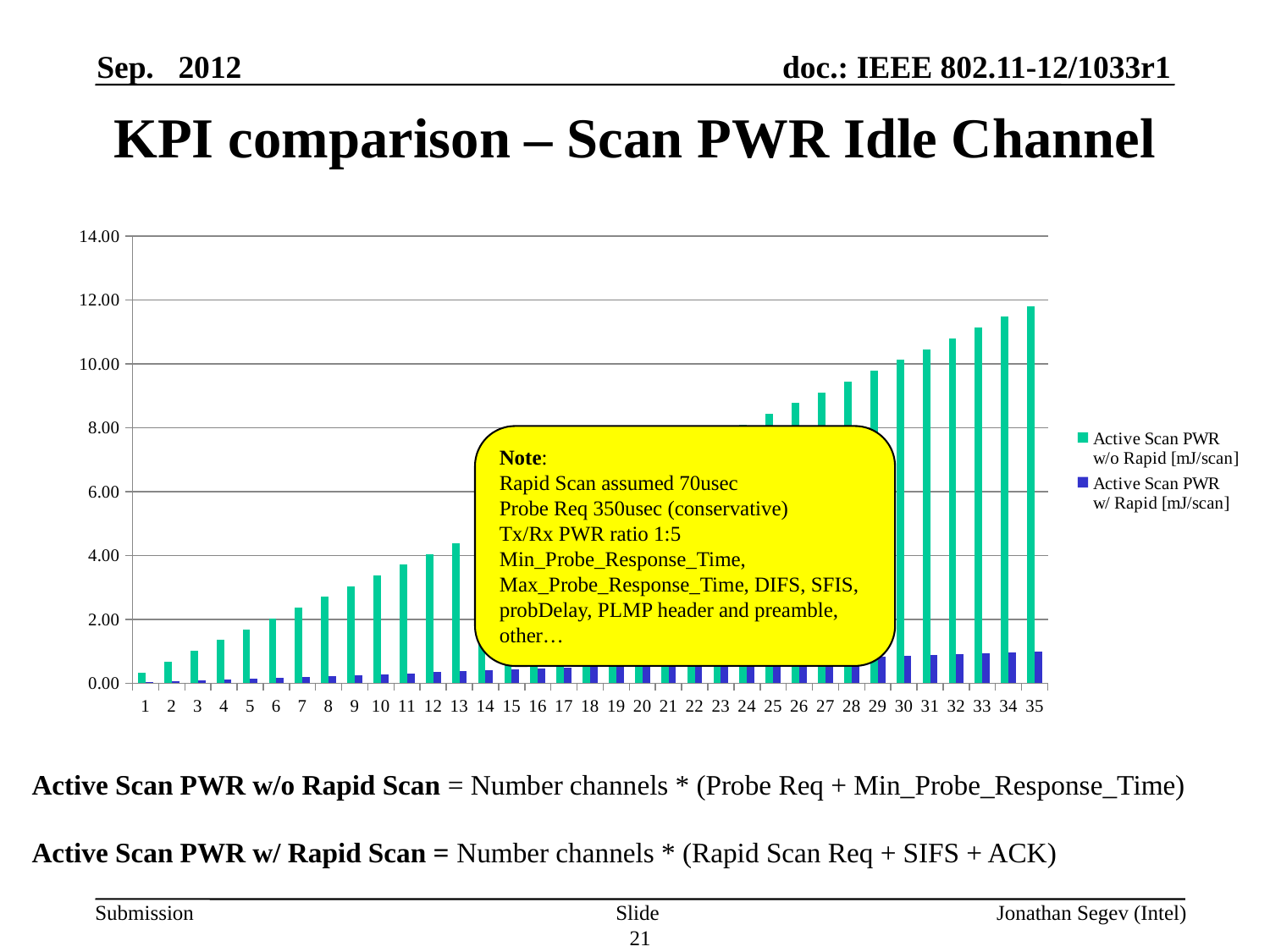
How many categories are shown along the x axis of the chart? 35 Is the value for Active Scan PWR w/o Rapid [mJ/scan] at category 35 greater or less than 10.00? greater Which category has the highest value for the Active Scan PWR w/o Rapid [mJ/scan] series? 35 What kind of chart is shown on the slide? bar chart Do the values of the Active Scan PWR w/o Rapid [mJ/scan] series rise or fall as the category number increases along the x axis? rise At category 35, which series has the larger value: Active Scan PWR w/o Rapid [mJ/scan] or Active Scan PWR w/ Rapid [mJ/scan]? Active Scan PWR w/o Rapid [mJ/scan] Is the value for Active Scan PWR w/o Rapid [mJ/scan] at category 5 greater or less than 2.00? less How many series does the chart legend list? 2 What colour are the bars for the Active Scan PWR w/ Rapid [mJ/scan] series? blue Is the value for Active Scan PWR w/ Rapid [mJ/scan] at category 35 greater or less than 2.00? less Which category has the lowest value for the Active Scan PWR w/o Rapid [mJ/scan] series? 1 What is the highest value shown on the chart's y axis? 14.00